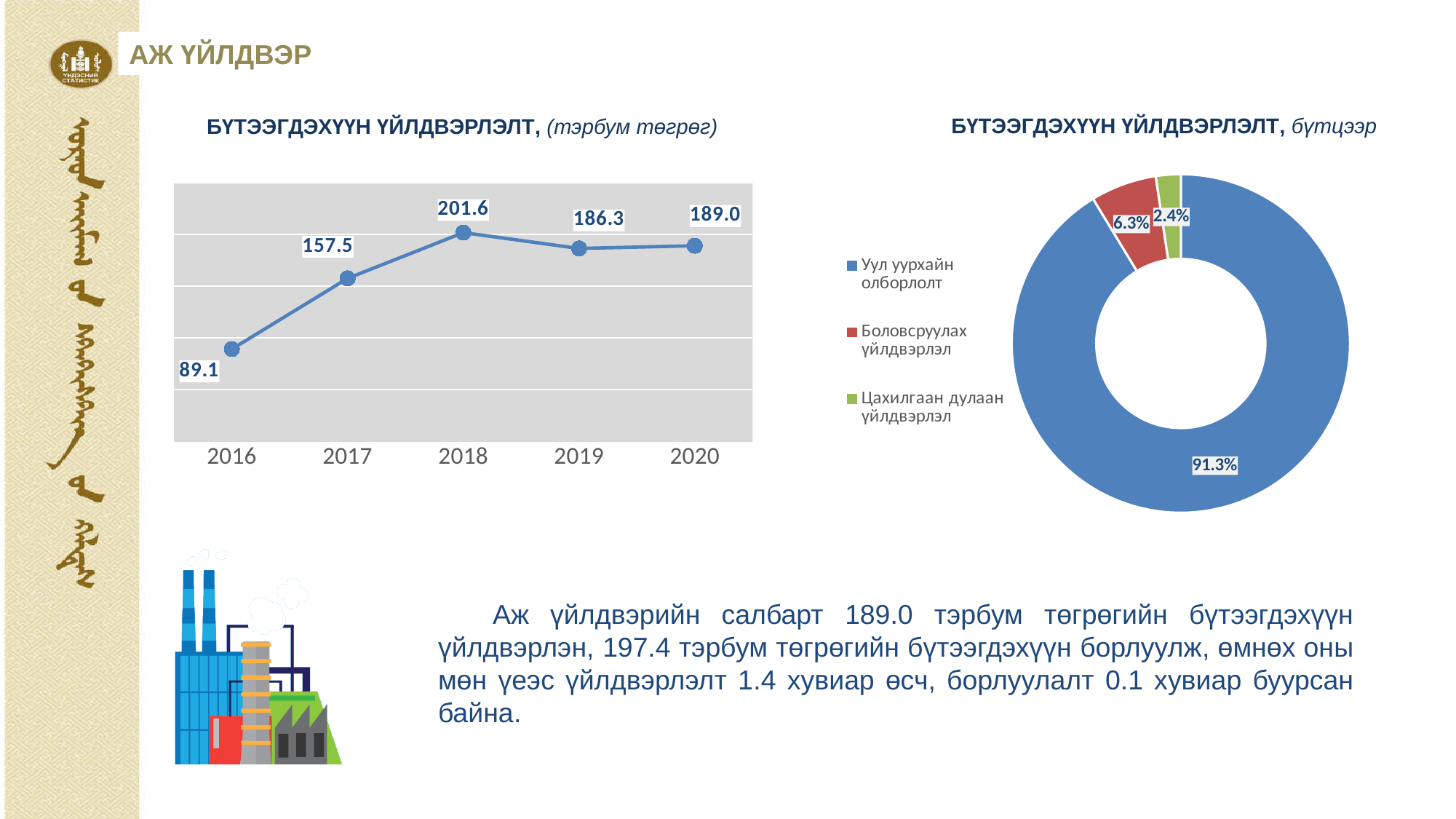
In the line chart on the left, which is larger, the value for 2019 or the value for 2020? 2020 In the line chart on the left, what is the difference between the 2018 and 2019 values? 15.3 In the line chart on the left, what is the value for 2016? 89.1 In the line chart on the left, which year has the highest value? 2018 What kind of chart is the chart on the left? line chart How many categories does the legend of the doughnut chart on the right list? 3 In the line chart on the left, do the values rise or fall from 2016 to 2018? rise In the doughnut chart on the right, what share does Боловсруулах үйлдвэрлэл have? 6.3% In the doughnut chart on the right (БҮТЭЭГДЭХҮҮН ҮЙЛДВЭРЛЭЛТ, бүтцээр), what share does Уул уурхайн олборлолт have? 91.3% In the line chart on the left, which year has the lowest value? 2016 In the line chart on the left, how many years are plotted? 5 In the line chart on the left (БҮТЭЭГДЭХҮҮН ҮЙЛДВЭРЛЭЛТ, тэрбум төгрөг), what is the value for 2018? 201.6